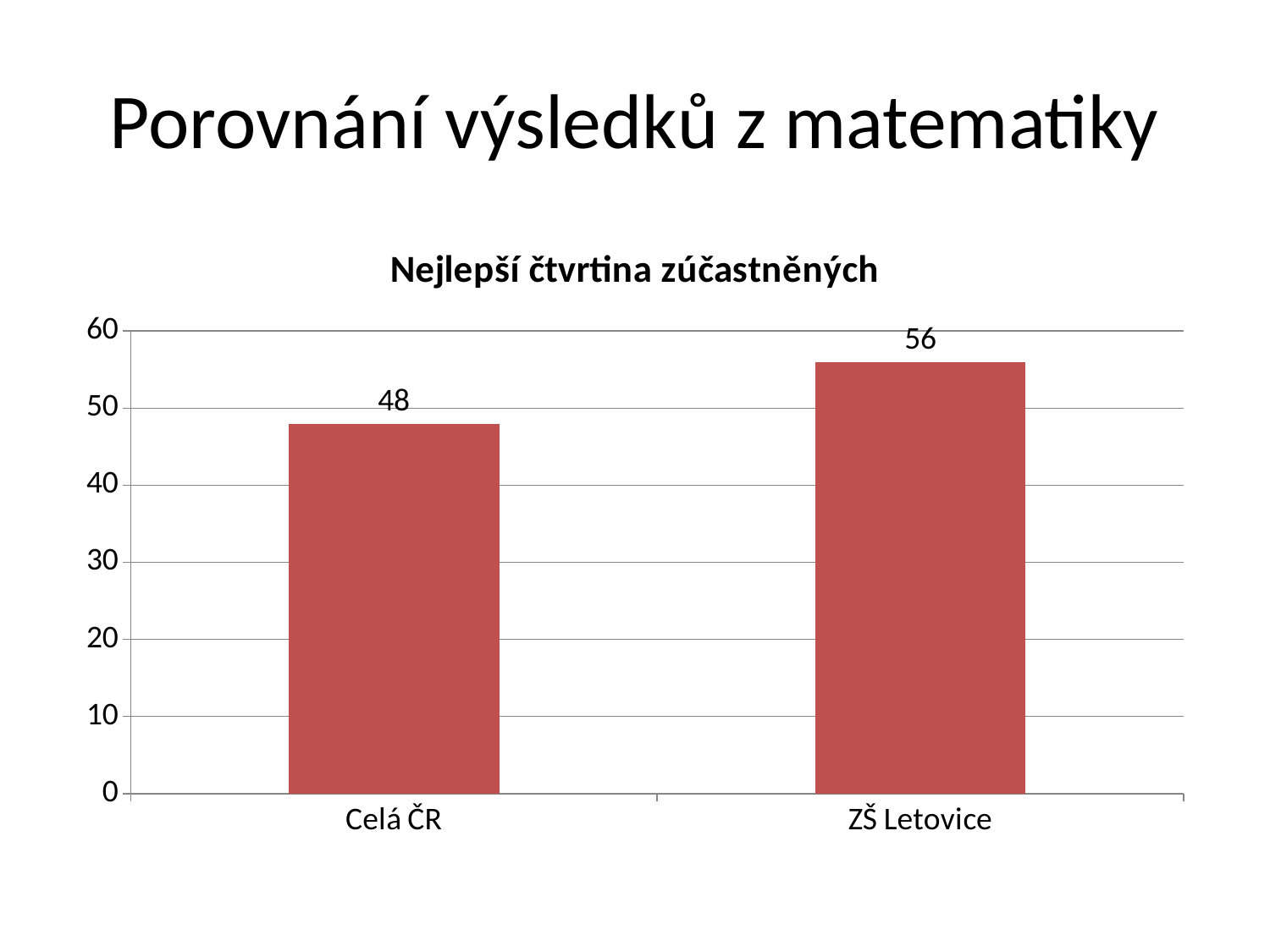
What is the value for ZŠ Letovice? 56 Which is larger, the value for Celá ČR or the value for ZŠ Letovice? ZŠ Letovice What is the title of the chart? Nejlepší čtvrtina zúčastněných What kind of chart is shown on the slide? bar chart Which category has the lowest value? Celá ČR Is the value for ZŠ Letovice greater or less than 50? greater Is the value for Celá ČR greater or less than 50? less How many categories are shown in the chart? 2 What is the difference between the values for ZŠ Letovice and Celá ČR? 8 Which category has the highest value? ZŠ Letovice What is the value for Celá ČR? 48 What is the highest value shown on the vertical axis? 60